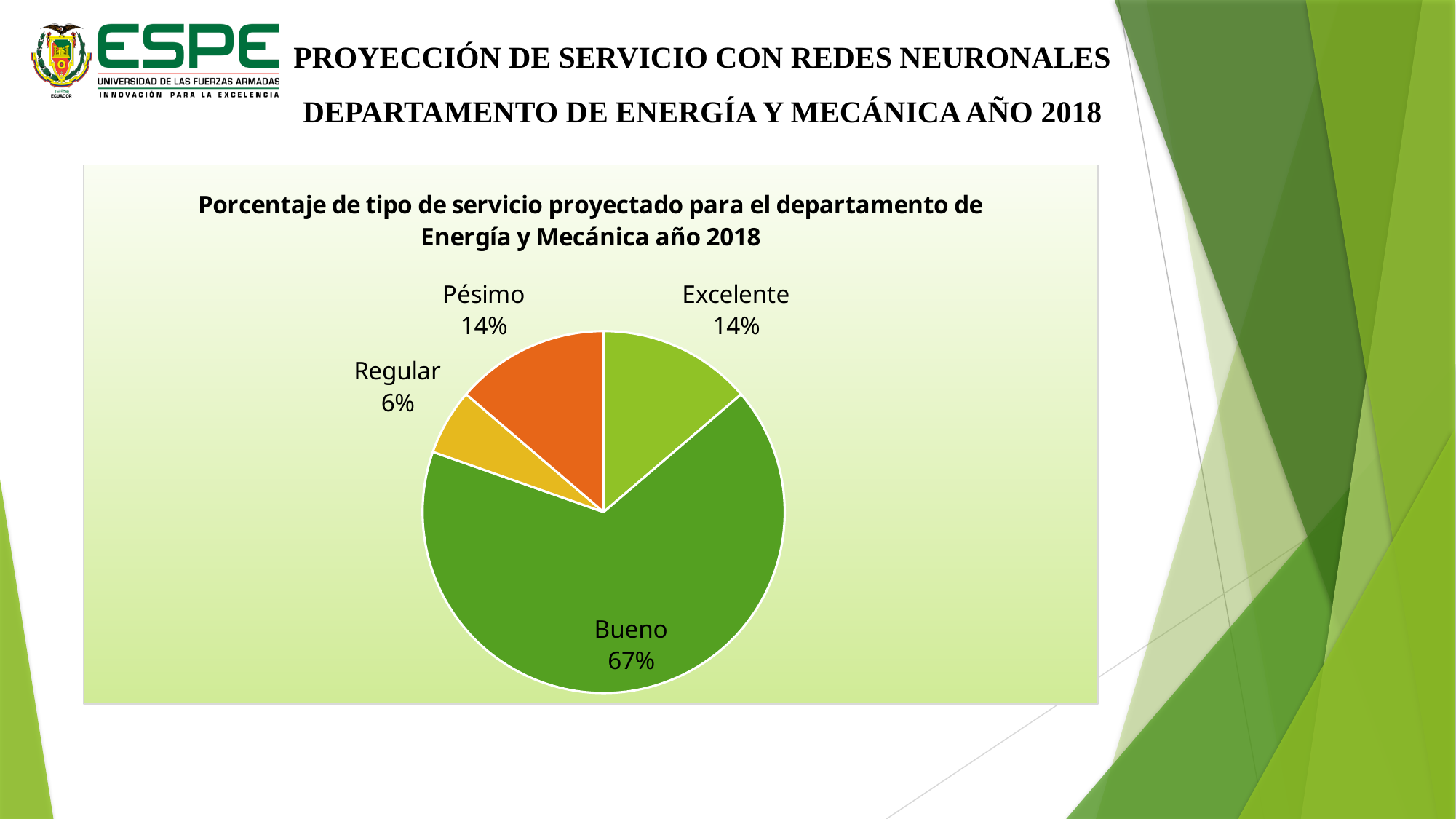
What is the difference in percentage points between Bueno and Pésimo? 53 What percentage is shown for Pésimo? 14% What type of chart is shown on the slide? Pie chart What percentage is shown for Regular? 6% What colour is the Pésimo slice? Orange What is the title of the chart? Porcentaje de tipo de servicio proyectado para el departamento de Energía y Mecánica año 2018 How many slices does the pie chart have? 4 What percentage is shown for Bueno? 67% What percentage is shown for Excelente? 14% Which category has the smallest share of the pie? Regular Which category has the largest share of the pie? Bueno Which is larger, the share for Regular or the share for Excelente? Excelente